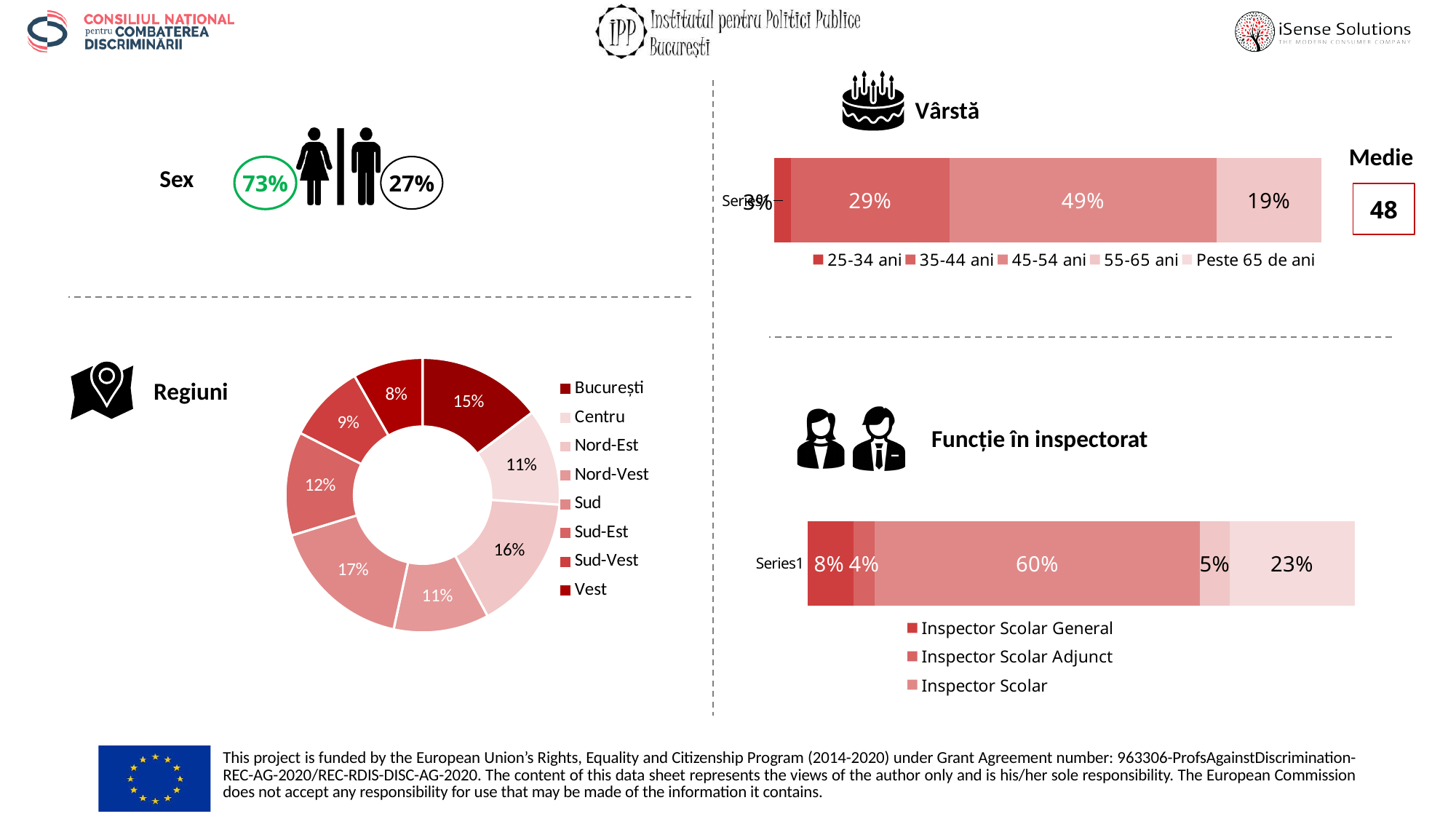
In the Vârstă chart, which age group has the largest share? 45-54 ani What kind of chart is the Vârstă chart? Stacked bar chart In the Regiuni chart, what percentage is shown for București? 15% How many age groups does the legend of the Vârstă chart list? 5 In the Regiuni chart, what percentage is shown for Sud? 17% In the Funcție în inspectorat chart, which is larger: Inspector Scolar General or Inspector Scolar Adjunct? Inspector Scolar General In the Regiuni chart, which region has the smallest share? Vest In the Vârstă chart, what is the difference between the 45-54 ani share and the 55-65 ani share? 30% In the Vârstă chart, what percentage is shown for the 35-44 ani group? 29% In the Vârstă chart, what percentage is shown for the 45-54 ani group? 49% In the Funcție în inspectorat chart, what percentage is shown for Inspector Scolar? 60% How many regions are shown in the Regiuni chart? 8